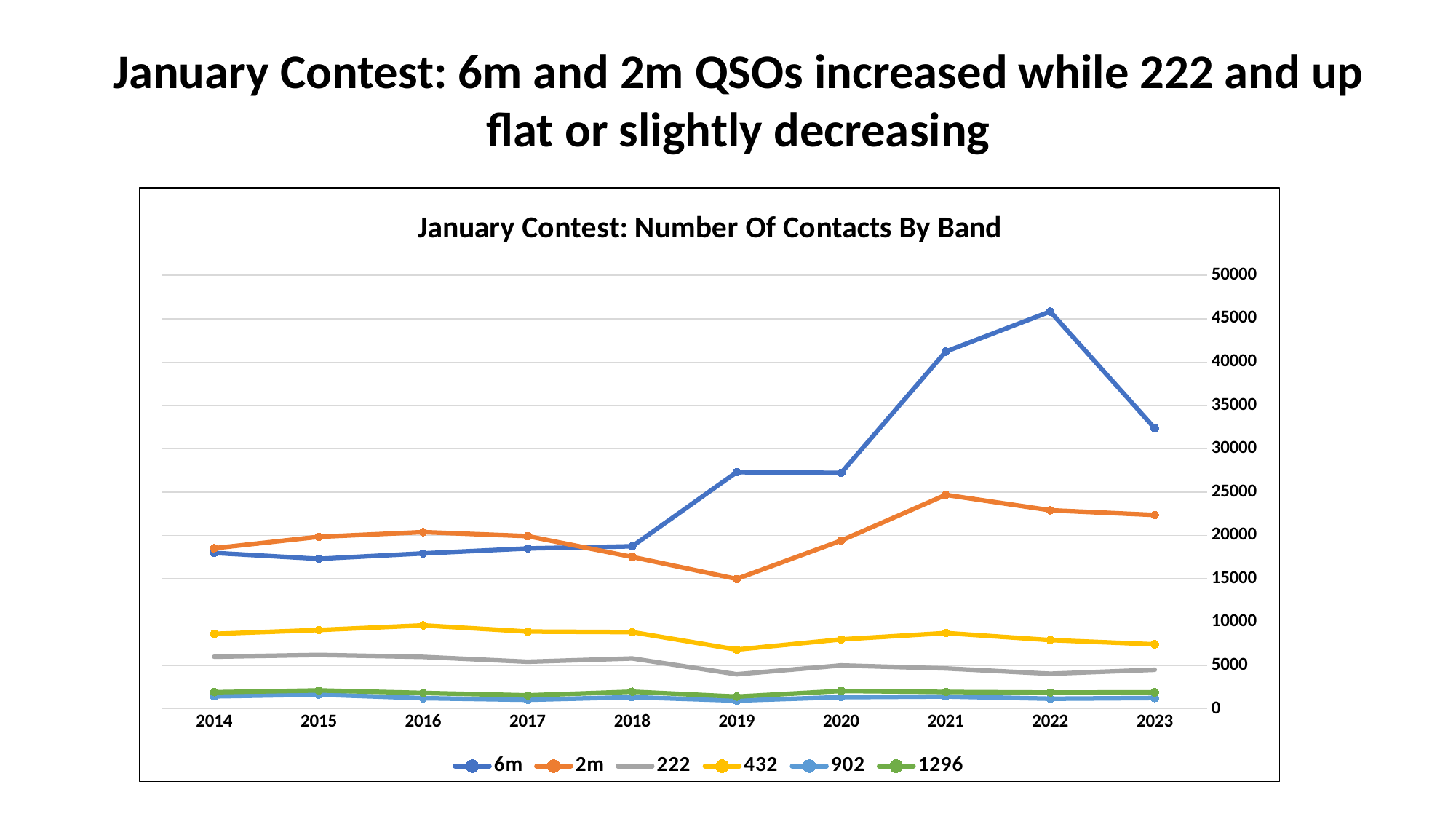
Is the value for 6m in 2022 greater or less than 40000? greater In 2023, which series has the higher value, 6m or 2m? 6m What is the title of the chart? January Contest: Number Of Contacts By Band Does the 6m series rise or fall from 2019 to 2022? rise What kind of chart is shown on the slide? line chart In which year does the 6m series reach its highest value? 2022 How many series does the legend list? 6 Is the value for 222 in 2022 greater or less than 5000? less In 2016, which series has the higher value, 6m or 2m? 2m Is the value for 2m in 2021 greater or less than 20000? greater How many years are plotted along the x axis? 10 In which year does the 2m series reach its lowest value? 2019